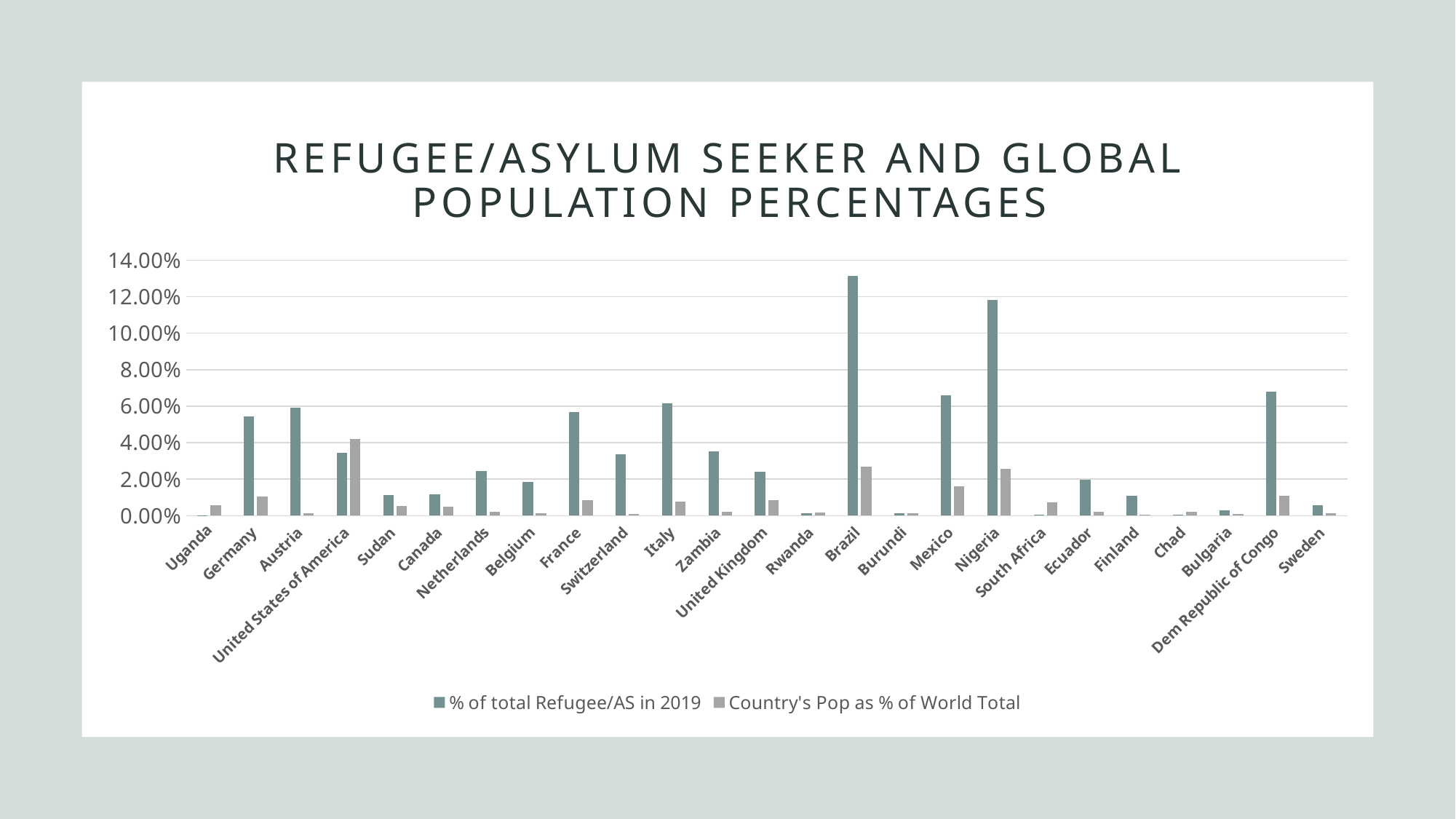
Which country has the larger % of total Refugee/AS in 2019, Brazil or Nigeria? Brazil Is the % of total Refugee/AS in 2019 for Sudan greater or less than 2.00%? less How many series does the legend list? 2 Is the % of total Refugee/AS in 2019 for Dem Republic of Congo greater or less than 6.00%? greater What kind of chart is shown on the slide? bar chart Is the % of total Refugee/AS in 2019 for Nigeria greater or less than 10.00%? greater Which country has the highest value for Country's Pop as % of World Total? United States of America Which country has the highest value for % of total Refugee/AS in 2019? Brazil What is the title of the chart? REFUGEE/ASYLUM SEEKER AND GLOBAL POPULATION PERCENTAGES Which is larger for the United States of America: % of total Refugee/AS in 2019 or Country's Pop as % of World Total? Country's Pop as % of World Total How many countries are shown on the x axis? 25